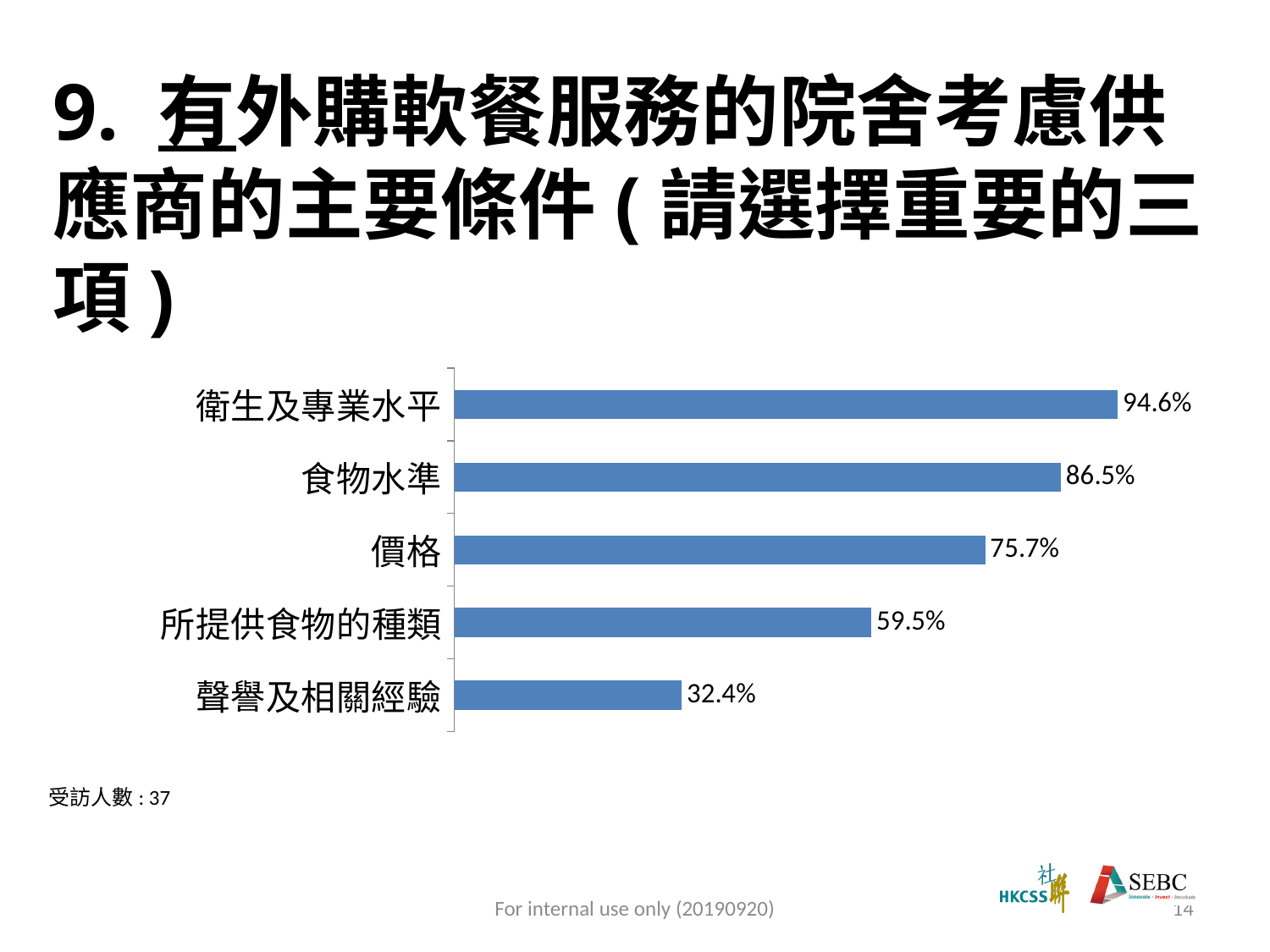
What is the value for 價格? 75.7% What is the value for 聲譽及相關經驗? 32.4% What is the difference between the values for 衛生及專業水平 and 食物水準? 8.1% What is the difference between the values for 價格 and 聲譽及相關經驗? 43.3% What is the value for 所提供食物的種類? 59.5% Which category has the lowest value? 聲譽及相關經驗 Which category has the highest value? 衛生及專業水平 What is the value for 衛生及專業水平? 94.6% What kind of chart is shown on the slide? bar chart What is the value for 食物水準? 86.5% How many categories are shown in the chart? 5 Which is larger, the value for 價格 or the value for 所提供食物的種類? 價格